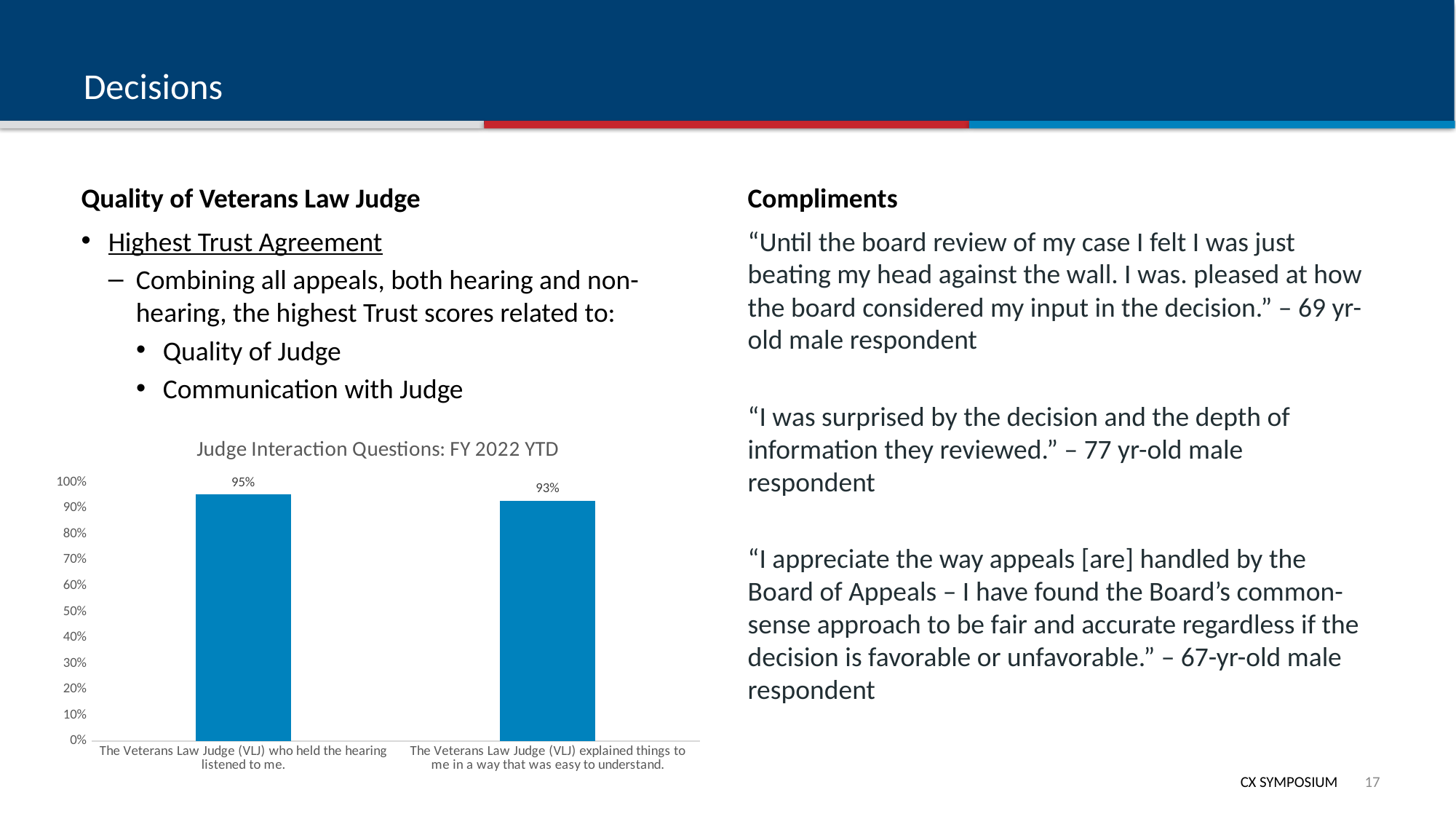
What is the difference between the value for "The Veterans Law Judge (VLJ) who held the hearing listened to me." and the value for "The Veterans Law Judge (VLJ) explained things to me in a way that was easy to understand."? 2% What is the title of the chart? Judge Interaction Questions: FY 2022 YTD What is the value for "The Veterans Law Judge (VLJ) who held the hearing listened to me."? 95% Which is larger: the value for "The Veterans Law Judge (VLJ) who held the hearing listened to me." or the value for "The Veterans Law Judge (VLJ) explained things to me in a way that was easy to understand."? The Veterans Law Judge (VLJ) who held the hearing listened to me. Which category has the lowest value? The Veterans Law Judge (VLJ) explained things to me in a way that was easy to understand. How many categories are shown in the chart? 2 Which category has the highest value? The Veterans Law Judge (VLJ) who held the hearing listened to me. What is the value for "The Veterans Law Judge (VLJ) explained things to me in a way that was easy to understand."? 93% What is the highest value shown on the chart's vertical axis? 100% Is the value for "The Veterans Law Judge (VLJ) explained things to me in a way that was easy to understand." greater or less than 90%? greater What kind of chart is shown on the slide? bar chart